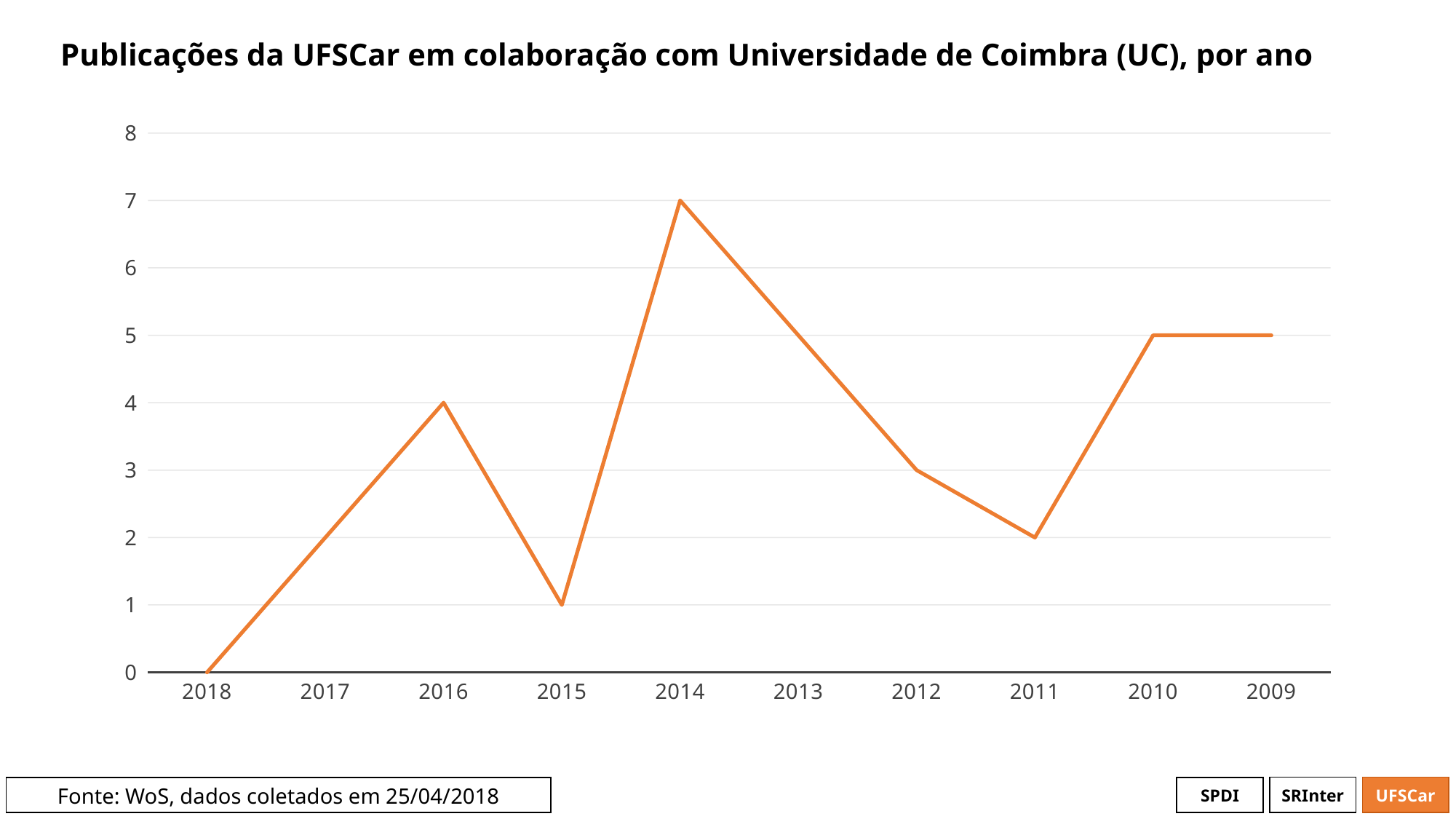
How many publications are shown for 2015? 1 What kind of chart is shown on the slide? line chart How many years are shown on the x axis? 10 Which year has more publications, 2016 or 2010? 2010 What is the difference between the number of publications in 2016 and in 2015? 3 How many publications are shown for 2014? 7 Is the value for 2017 greater or less than 3? less How many publications are shown for 2010? 5 What is the difference between the number of publications in 2014 and in 2012? 4 Which year has the highest number of publications? 2014 Which year has the lowest number of publications? 2018 How many publications are shown for 2018? 0